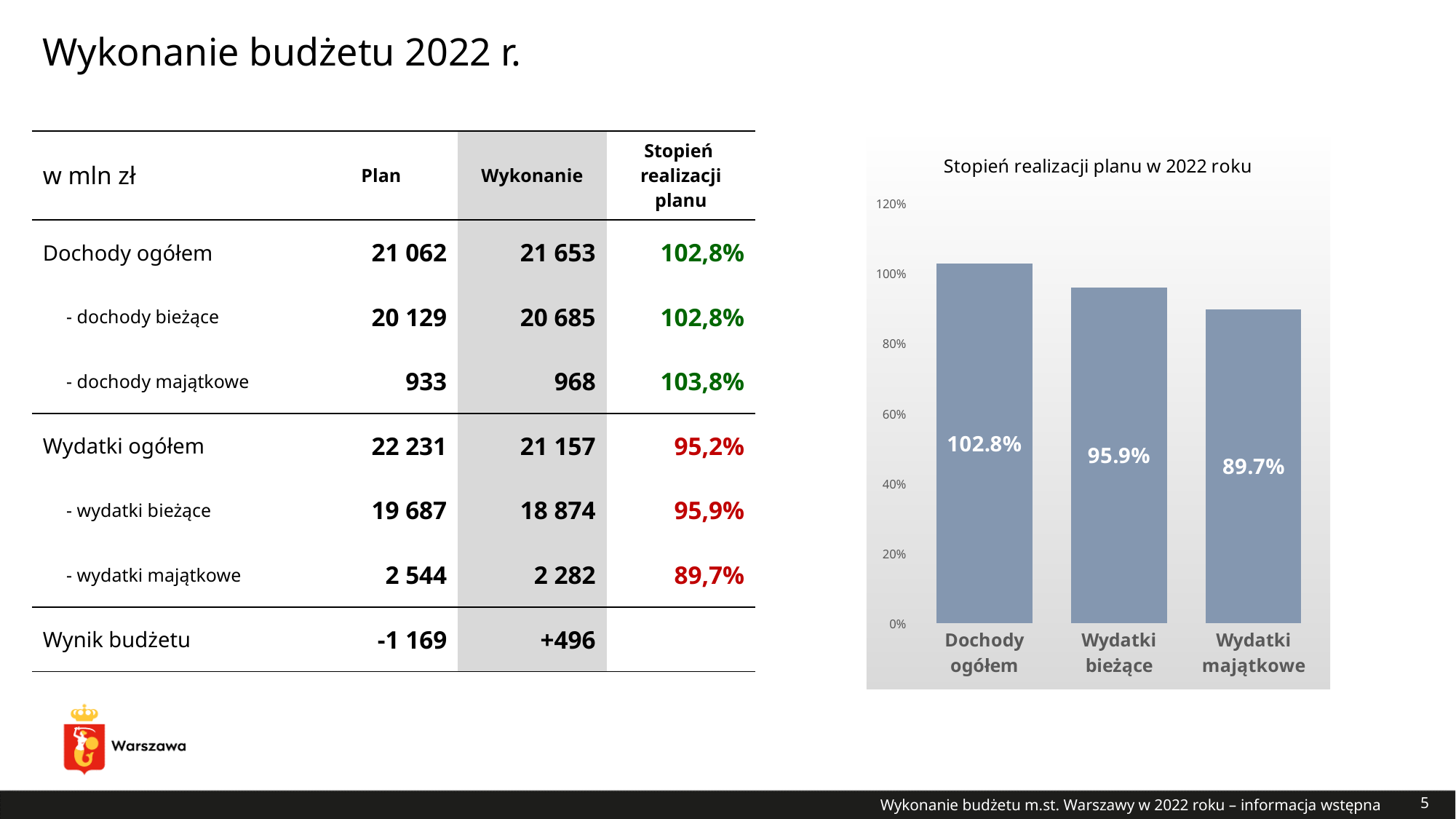
What is the value for Wydatki bieżące in the chart? 95.9% Which category has the highest value in the chart? Dochody ogółem What is the value for Dochody ogółem in the chart? 102.8% How many bars does the chart show? 3 Which is larger in the chart, the value for Wydatki bieżące or Wydatki majątkowe? Wydatki bieżące What is the title of the chart on the slide? Stopień realizacji planu w 2022 roku What type of chart is shown on the slide? bar chart What is the value for Wydatki majątkowe in the chart? 89.7% Is the value for Wydatki majątkowe in the chart greater or less than 100%? less What is the difference between the values for Dochody ogółem and Wydatki majątkowe in the chart? 13.1% Which category has the lowest value in the chart? Wydatki majątkowe Do the values in the chart rise or fall from left to right? fall